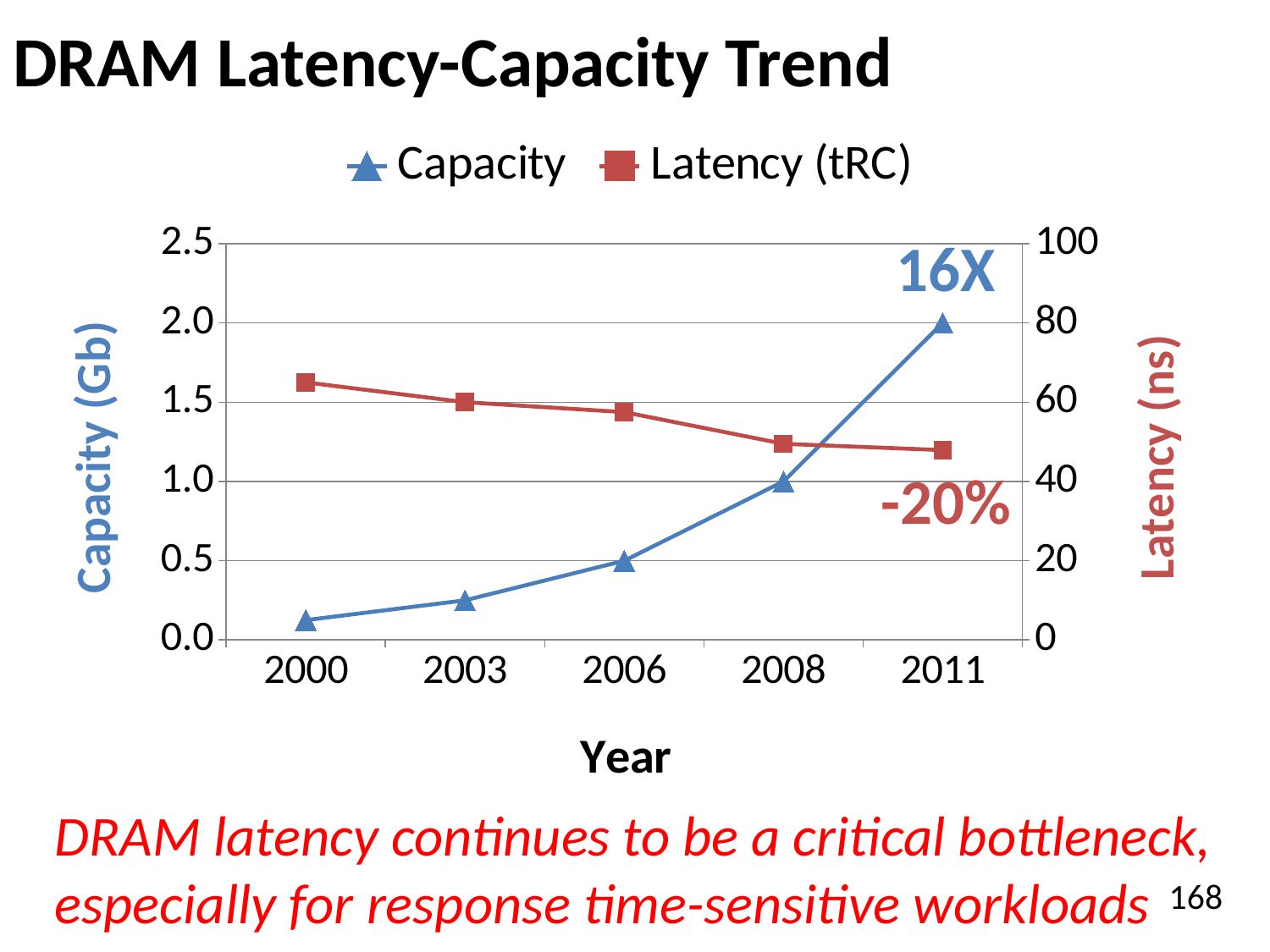
Which year has the lowest latency (tRC)? 2011 What annotation is printed next to the capacity line at 2011? 16X What is the latency (tRC) value for 2003? 60 What is the capacity value for 2011? 2.0 What kind of chart is shown on the slide? line chart How many series does the legend list? 2 Is the latency (tRC) value for 2000 greater or less than 60? greater Is the capacity value for 2006 greater or less than 1.0? less How many years are plotted along the x axis? 5 What is the capacity value for 2008? 1.0 Which year has the highest capacity? 2011 Does the latency (tRC) series rise or fall from 2000 to 2011? fall